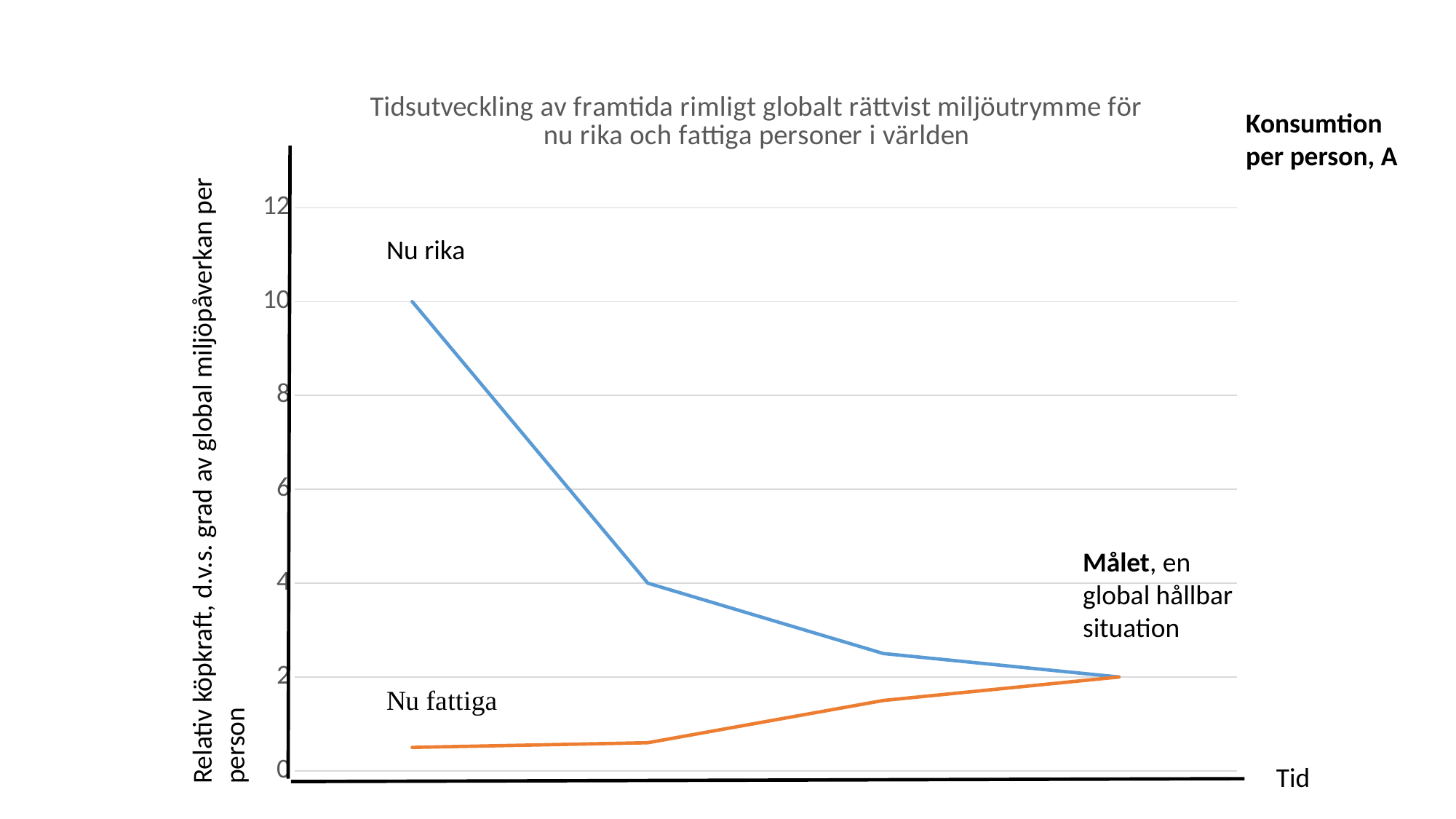
What kind of chart is shown on the slide? line chart How many lines (series) are plotted on the chart? 2 Is the third point of the 'Nu rika' line greater or less than 2? greater Does the 'Nu rika' line rise or fall along the x axis? fall What is the value of the 'Nu rika' line at its second point? 4 Is the starting value of the 'Nu fattiga' line greater or less than 2? less What is the label on the x axis of the chart? Tid What is the starting value of the 'Nu rika' line at the left of the chart? 10 Does the 'Nu fattiga' line rise or fall along the x axis? rise At what value do the 'Nu rika' and 'Nu fattiga' lines meet at the right end of the chart? 2 How many points does each line have? 4 Which line starts higher at the left of the chart, 'Nu rika' or 'Nu fattiga'? Nu rika